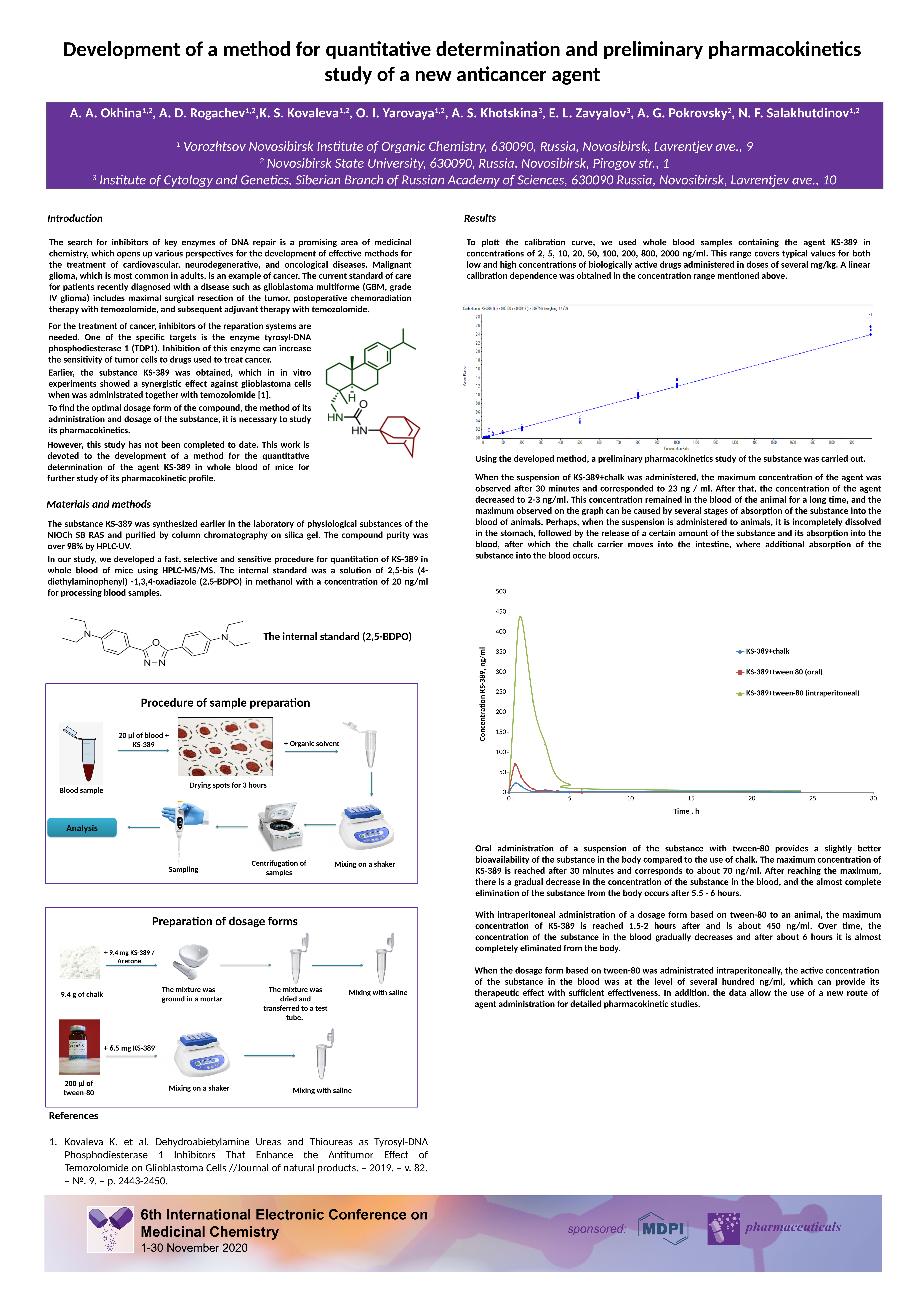
In the chart with the x axis labelled 'Time , h', which series reaches the highest concentration? KS-389+tween-80 (intraperitoneal) In the chart with the x axis labelled 'Time , h', how many series does the legend list? 3 In the chart with the x axis labelled 'Time , h', is the peak value for KS-389+tween-80 (intraperitoneal) greater or less than 400? greater In the chart with the x axis labelled 'Time , h', which series has the lowest peak concentration? KS-389+chalk What is the y-axis label of the chart with the x axis labelled 'Time , h'? Concentration KS-389, ng/ml In the chart with the x axis labelled 'Time , h', is the peak value for KS-389+tween 80 (oral) greater or less than 100? less What kind of chart is the chart with the x axis labelled 'Time , h'? line chart In the chart with the x axis labelled 'Time , h', is the peak value for KS-389+chalk greater or less than 50? less What is the x-axis label of the calibration chart at the top right? Concentration Ratio In the chart with the x axis labelled 'Time , h', which series has the higher peak: KS-389+tween 80 (oral) or KS-389+chalk? KS-389+tween 80 (oral) In the calibration chart at the top right, do the Area Ratio values rise or fall as Concentration Ratio increases? rise In the chart with the x axis labelled 'Time , h', does the KS-389+tween-80 (intraperitoneal) concentration rise or fall between 5 h and 25 h? fall